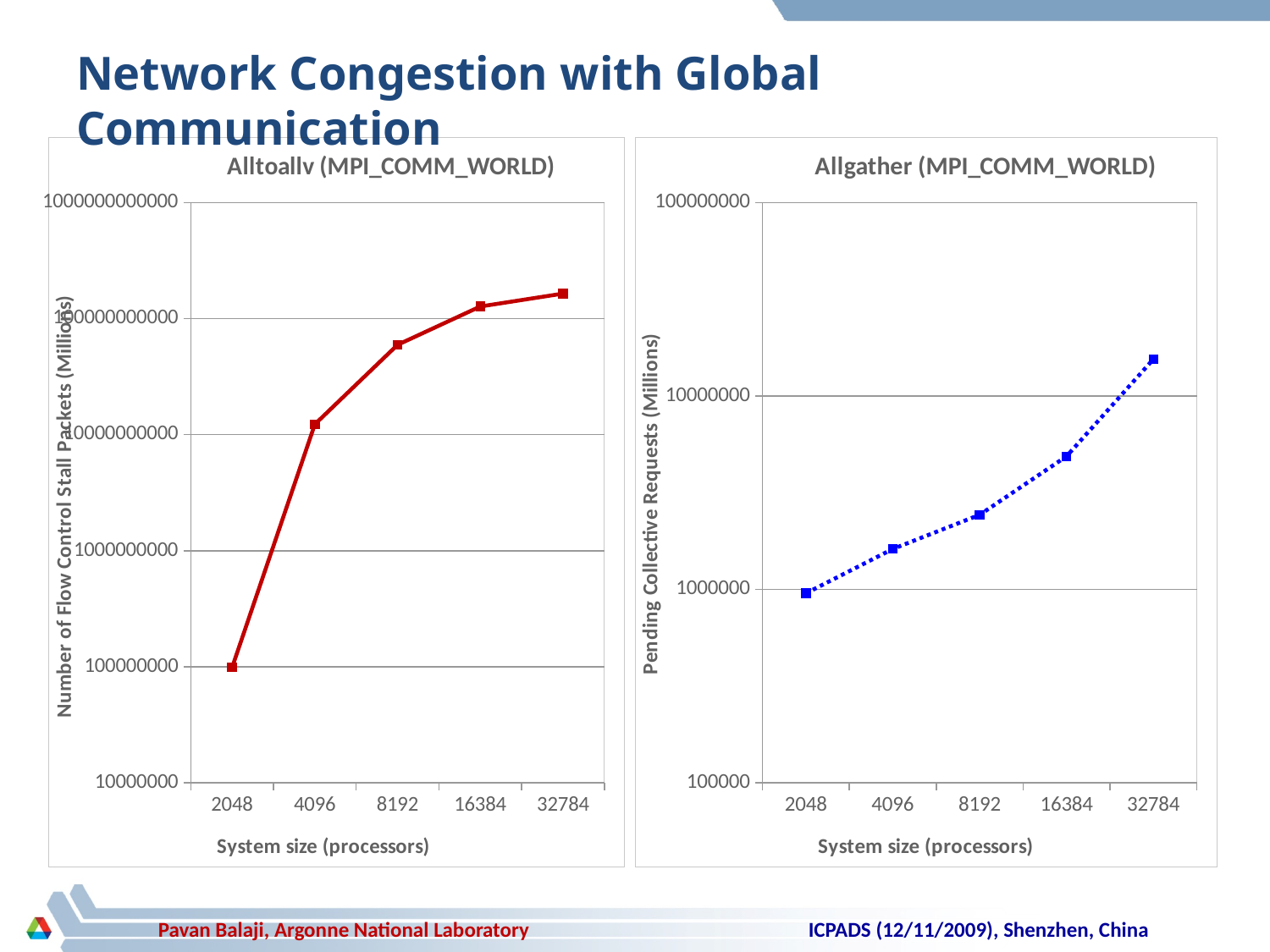
In the Allgather (MPI_COMM_WORLD) chart, is the value at system size 16384 greater or less than 10000000? less In the Allgather (MPI_COMM_WORLD) chart, which system size has the lowest number of pending collective requests? 2048 In the Alltoallv (MPI_COMM_WORLD) chart, is the value at system size 4096 greater or less than 10000000000? greater What is the y-axis label of the Allgather (MPI_COMM_WORLD) chart? Pending Collective Requests (Millions) In the Alltoallv (MPI_COMM_WORLD) chart, which system size has the highest number of flow control stall packets? 32784 What type of chart is the Alltoallv (MPI_COMM_WORLD) chart on the left? Line chart In the Alltoallv (MPI_COMM_WORLD) chart, how many system sizes are plotted along the x axis? 5 In the Alltoallv (MPI_COMM_WORLD) chart, is the value at system size 8192 greater or less than 100000000000? less In the Allgather (MPI_COMM_WORLD) chart, do the pending collective requests rise or fall as system size increases? Rise